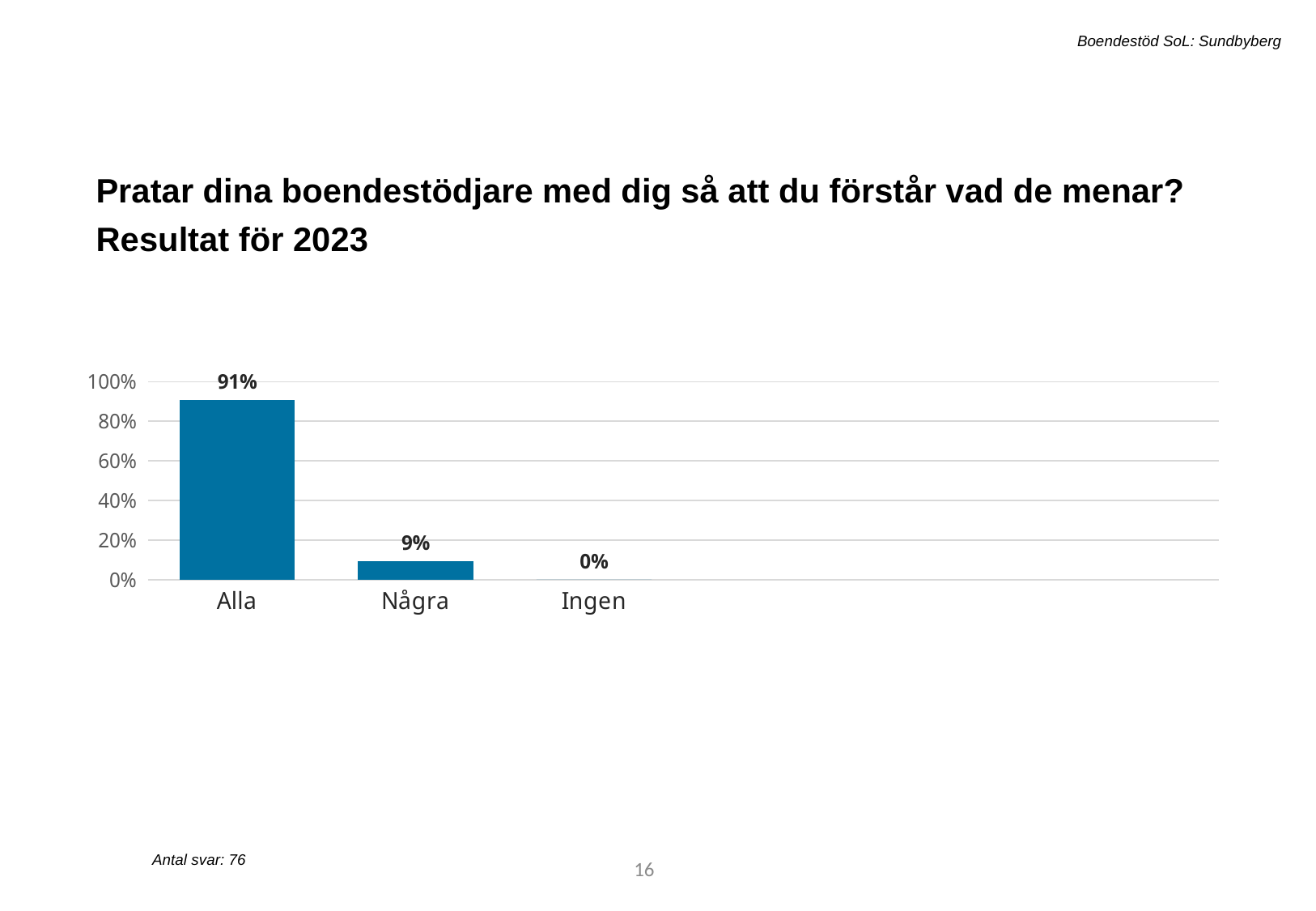
What kind of chart is shown on the slide? bar chart How many responses (Antal svar) does the slide report? 76 What is the difference between the values for Alla and Några? 82% Is the value for Några greater or less than 20%? less What is the value for Alla? 91% Which is larger, the value for Några or the value for Ingen? Några How many categories are shown on the x axis? 3 What is the value for Ingen? 0% Which category has the highest value? Alla What is the value for Några? 9% Which category has the lowest value? Ingen Is the value for Alla greater or less than 80%? greater